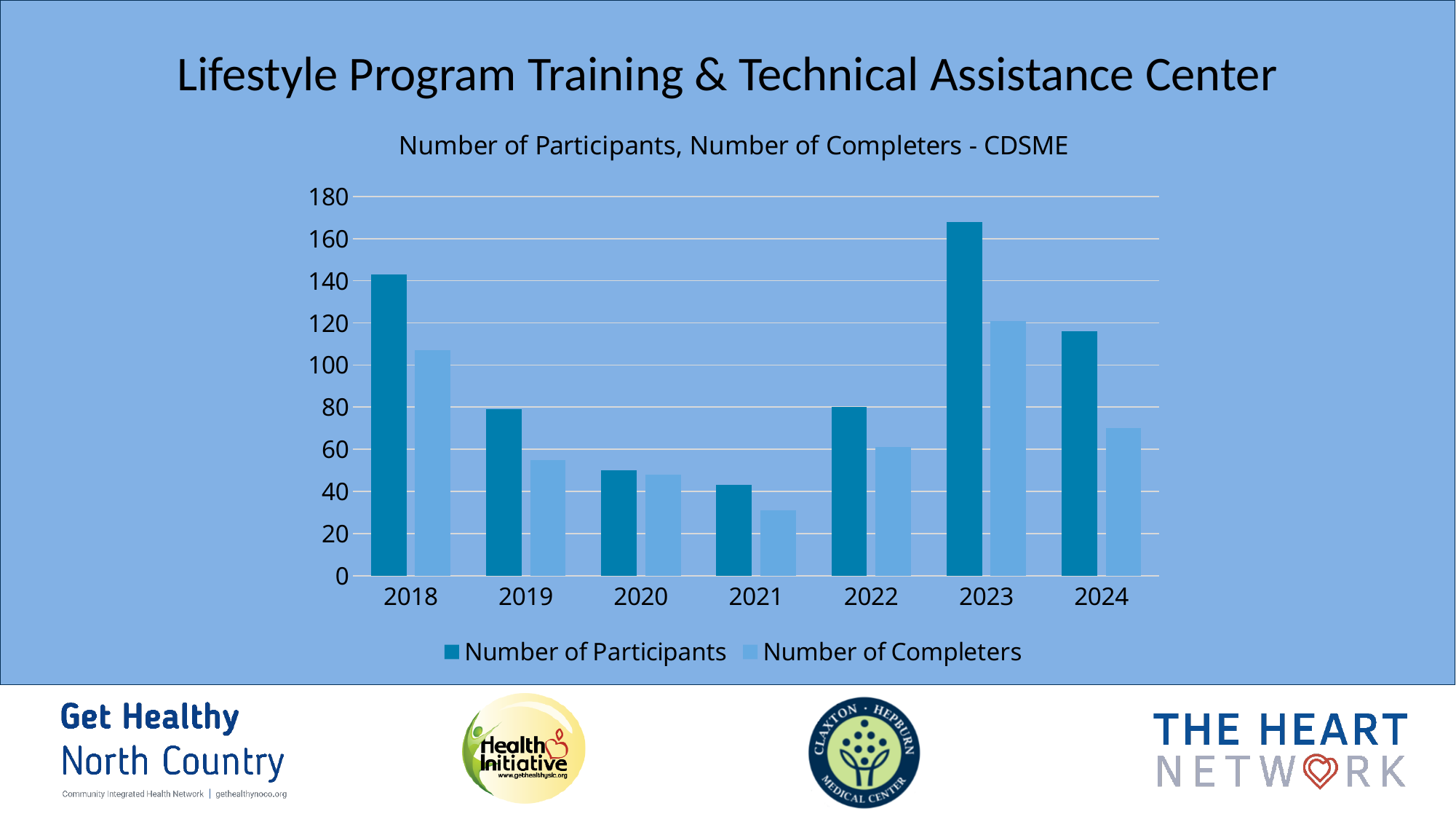
Which is larger, the Number of Participants in 2018 or in 2024? 2018 Which year has the highest Number of Participants? 2023 Which year has the lowest Number of Participants? 2021 Is the Number of Participants for 2018 greater or less than 120? greater What kind of chart is shown on the slide? Bar chart Do the Number of Participants values rise or fall from 2018 to 2021? fall What is the subtitle of the chart? Number of Participants, Number of Completers - CDSME Is the Number of Completers for 2021 greater or less than 40? less Which year has the lowest Number of Completers? 2021 How many years are shown on the x axis? 7 How many series does the legend list? 2 Is the Number of Participants for 2023 greater or less than 160? greater